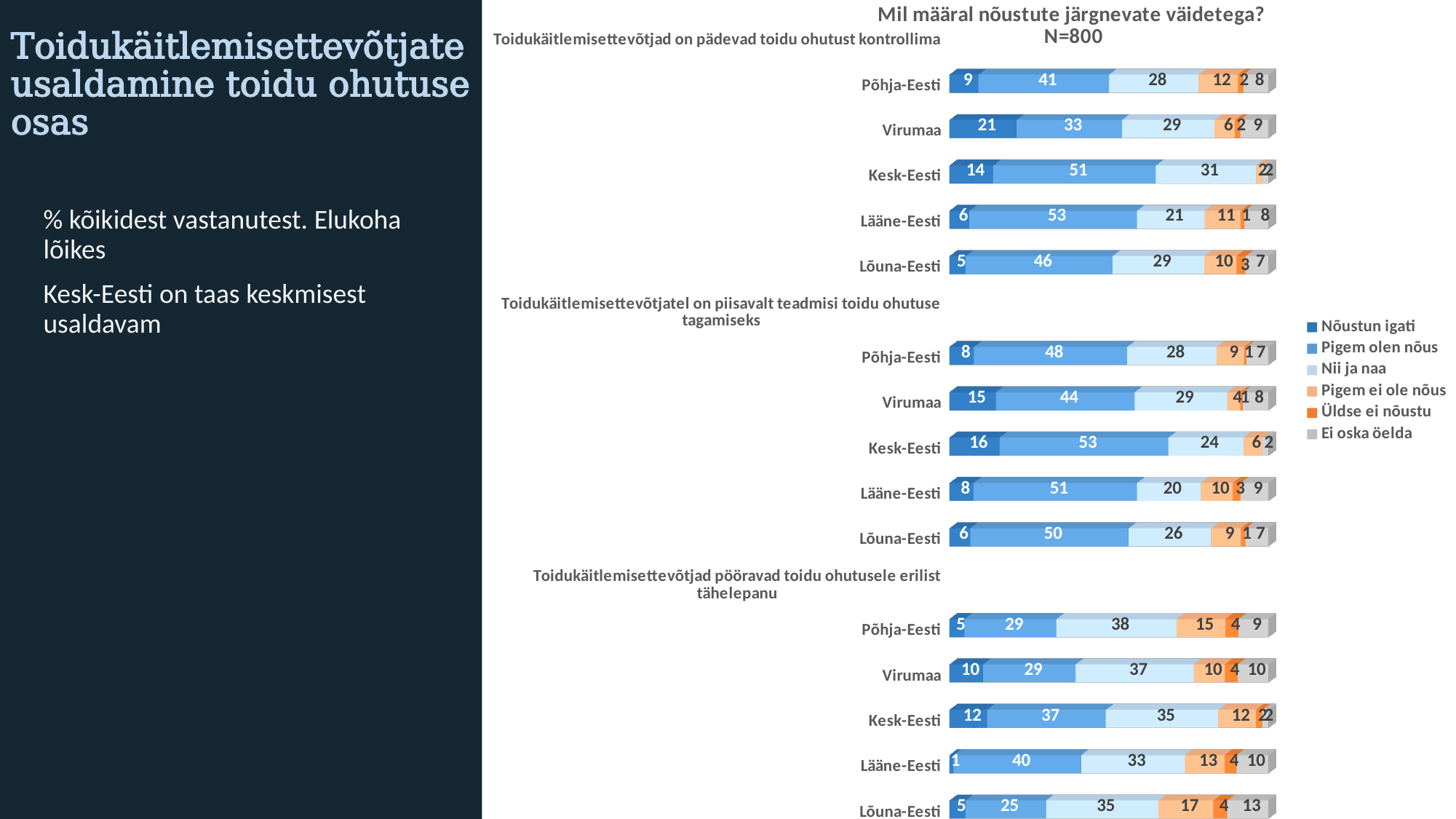
What sample size (N) is stated in the chart title? N=800 How many series does the legend list? 6 In the section 'Toidukäitlemisettevõtjad pööravad toidu ohutusele erilist tähelepanu', which region has the lowest 'Nõustun igati' value? Lääne-Eesti In the section 'Toidukäitlemisettevõtjad on pädevad toidu ohutust kontrollima', which region has the highest 'Nõustun igati' value? Virumaa In the section 'Toidukäitlemisettevõtjatel on piisavalt teadmisi toidu ohutuse tagamiseks', what is the 'Pigem olen nõus' value for Kesk-Eesti? 53 In the section 'Toidukäitlemisettevõtjad pööravad toidu ohutusele erilist tähelepanu', what is the 'Nii ja naa' value for Põhja-Eesti? 38 Which legend entry is shown in grey? Ei oska öelda In the section 'Toidukäitlemisettevõtjatel on piisavalt teadmisi toidu ohutuse tagamiseks', what is the difference between the 'Pigem olen nõus' values for Kesk-Eesti and Virumaa? 9 In the section 'Toidukäitlemisettevõtjad on pädevad toidu ohutust kontrollima', what is the 'Nõustun igati' value for Virumaa? 21 In the section 'Toidukäitlemisettevõtjad pööravad toidu ohutusele erilist tähelepanu', which is larger: the 'Ei oska öelda' value for Lõuna-Eesti or for Põhja-Eesti? Lõuna-Eesti How many regions are shown under each statement in the chart? 5 What kind of chart is shown on the slide? Stacked bar chart